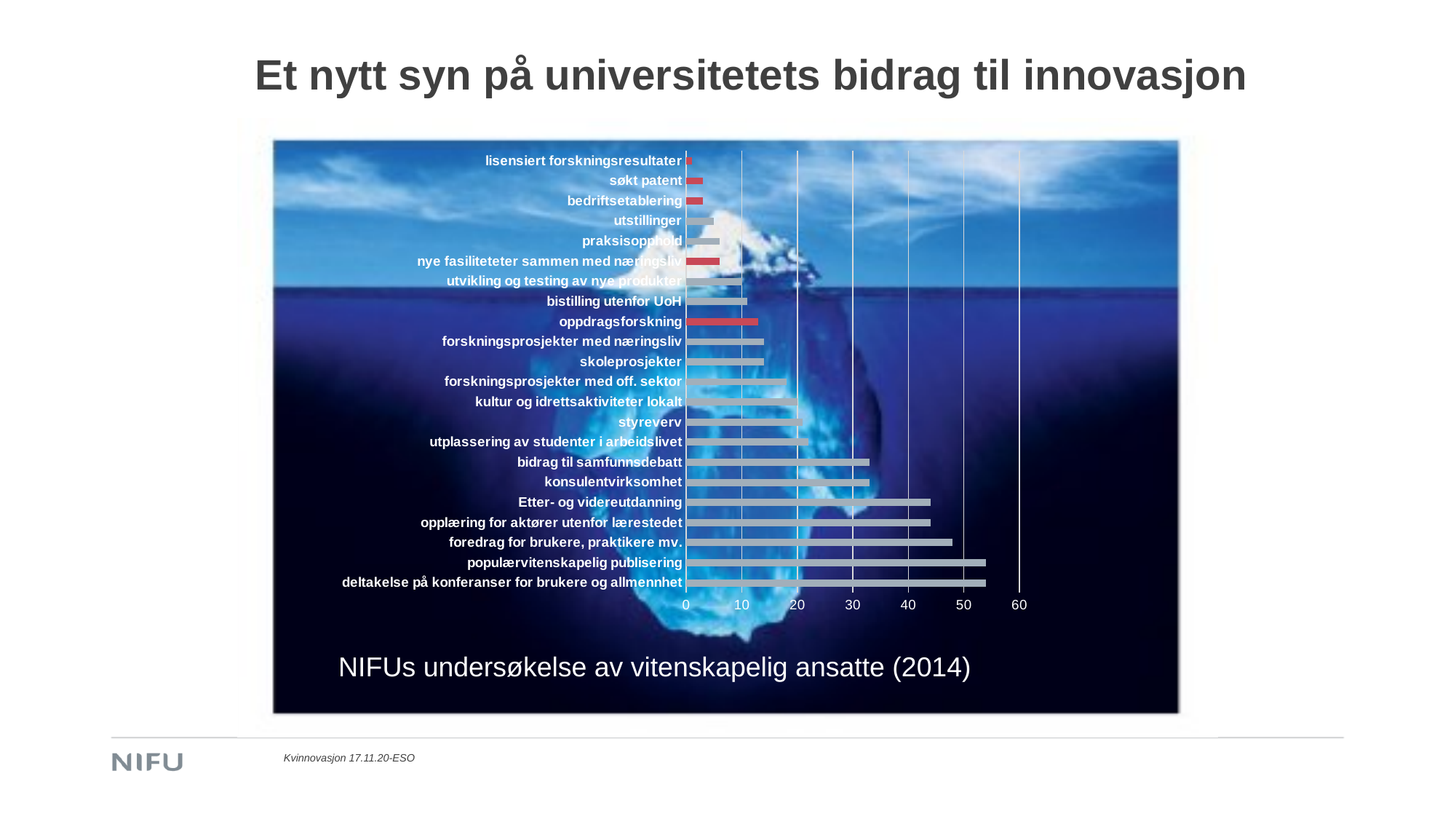
Is the value for utstillinger greater or less than 10? less Is the value for styreverv greater or less than 30? less Which category has the lowest value in the chart? lisensiert forskningsresultater Is the value for foredrag for brukere, praktikere mv. greater or less than 40? greater What data source is named below the chart? NIFUs undersøkelse av vitenskapelig ansatte (2014) How many bars in the chart are coloured red rather than grey? 5 How many categories are plotted in the chart? 22 Which is larger, the value for oppdragsforskning or the value for søkt patent? oppdragsforskning Which is larger, the value for bidrag til samfunnsdebatt or the value for styreverv? bidrag til samfunnsdebatt What kind of chart is shown on the slide? bar chart